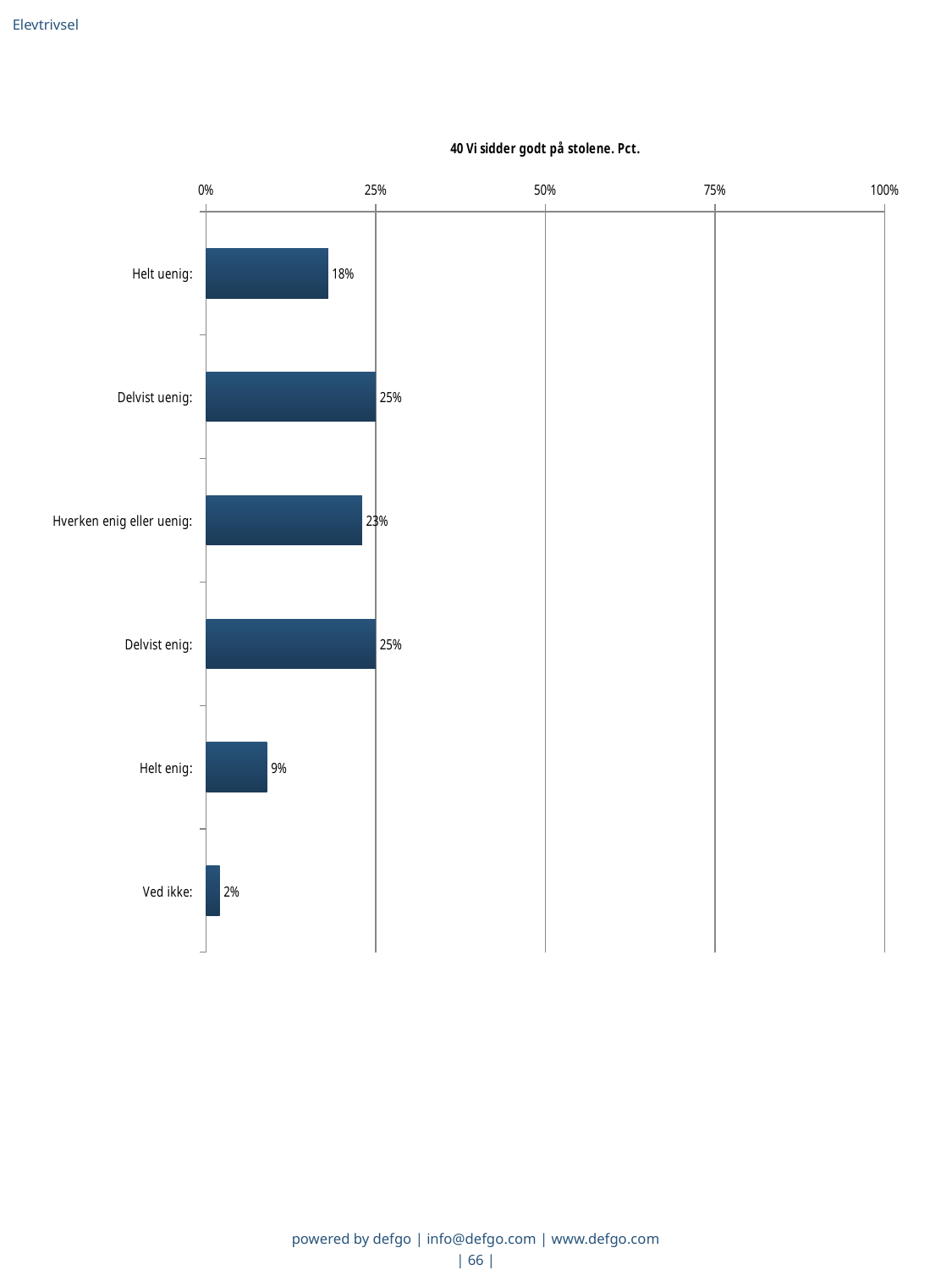
Which is larger, the value for Hverken enig eller uenig or the value for Helt enig? Hverken enig eller uenig How many categories are shown in the chart? 6 What is the value for Delvist enig? 25% Which category has the lowest value? Ved ikke What is the value for Helt enig? 9% What is the difference between the values for Delvist uenig and Helt uenig? 7% What kind of chart is shown on the slide? Bar chart What is the value for Ved ikke? 2% What is the title of the chart? 40 Vi sidder godt på stolene. Pct. What is the value for Hverken enig eller uenig? 23% What is the difference between the values for Helt enig and Ved ikke? 7% What is the value for Helt uenig? 18%